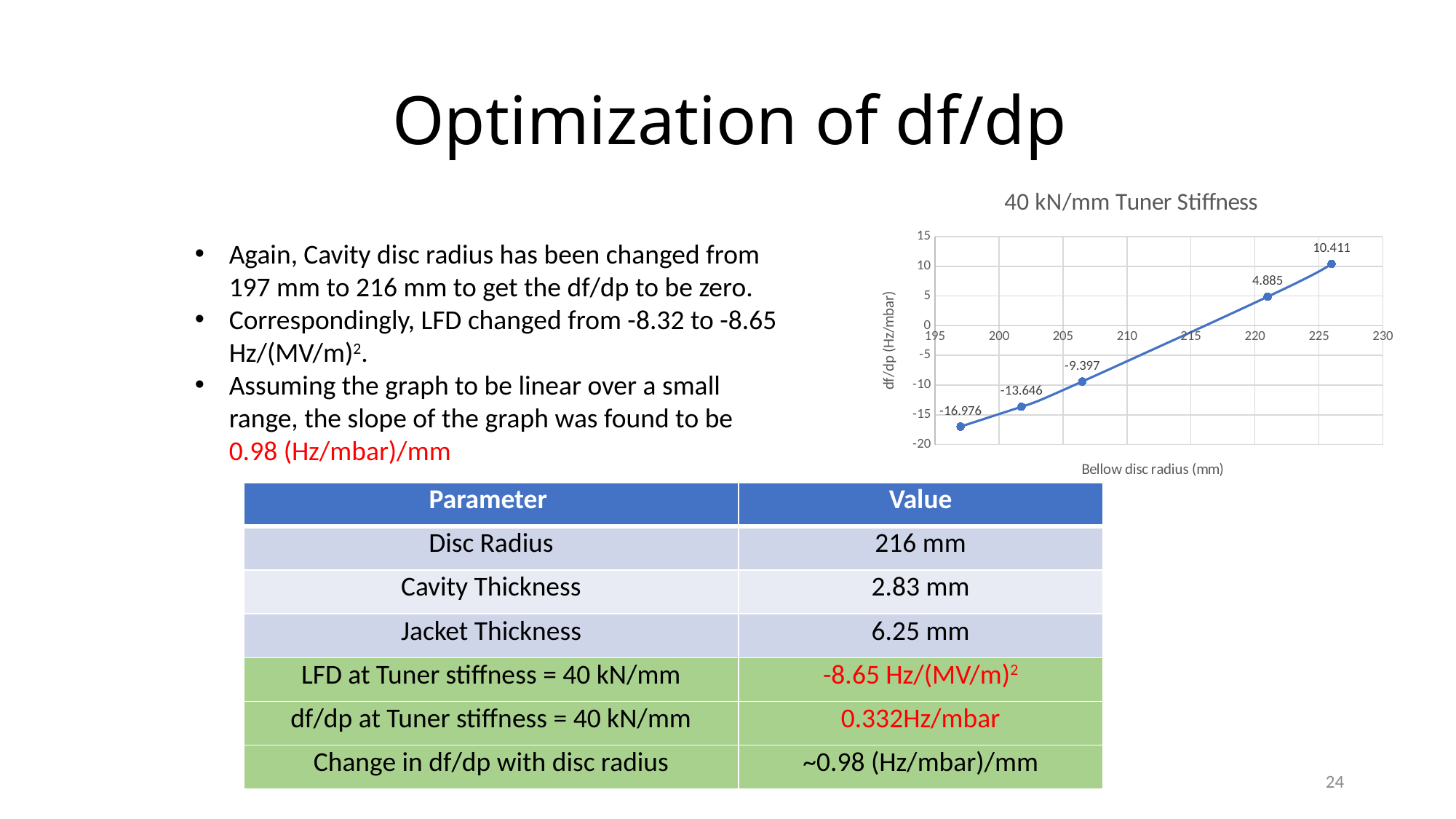
What is the highest df/dp value labelled on the chart? 10.411 How many of the plotted points have a negative df/dp value? 3 What is the lowest df/dp value labelled on the chart? -16.976 Does df/dp rise or fall as the bellow disc radius increases along the x axis? rise Is the df/dp value of the rightmost point greater or less than 10? greater What is the difference between the two positive labelled values, 10.411 and 4.885? 5.526 What is the title of the chart? 40 kN/mm Tuner Stiffness What kind of chart is shown on the slide? line chart How many data points are plotted on the chart? 5 What is the label of the chart's x axis? Bellow disc radius (mm) What is the difference between the labelled values -9.397 and -13.646? 4.249 What is the difference between the highest and lowest labelled df/dp values on the chart? 27.387